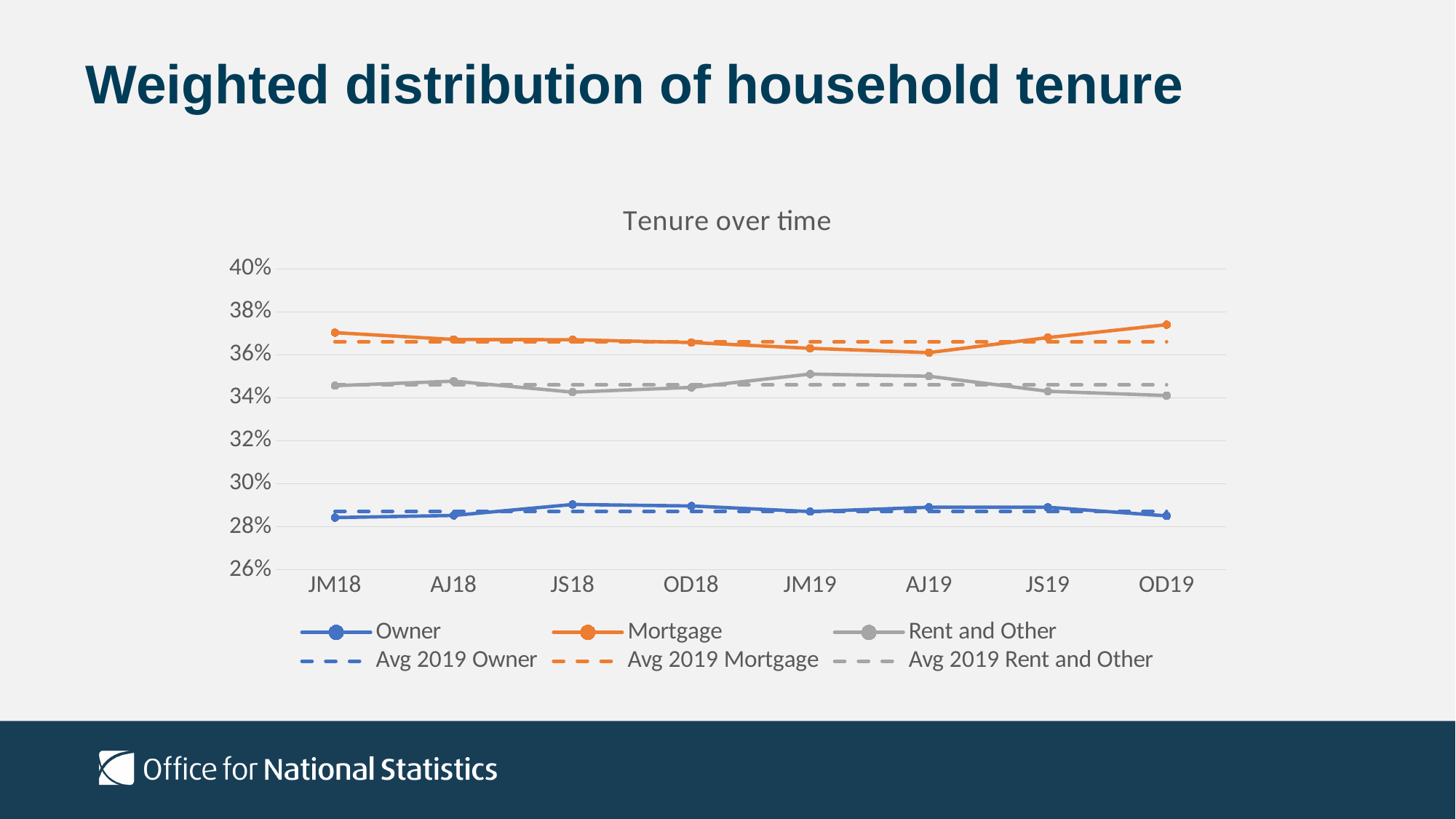
Which series are drawn with dashed lines? Avg 2019 Owner, Avg 2019 Mortgage, Avg 2019 Rent and Other How many time periods are shown along the x axis? 8 Which series has the lowest value at JS18? Owner How many series does the legend list? 6 Which series has the highest value at OD19? Mortgage Is the value for Mortgage at OD19 greater or less than 36%? greater Is the value for Mortgage at AJ19 greater or less than 38%? less Which is larger at JM18, Mortgage or Rent and Other? Mortgage Is the value for Owner at JM18 greater or less than 30%? less What is the title of the chart? Tenure over time What kind of chart is shown on the slide? line chart